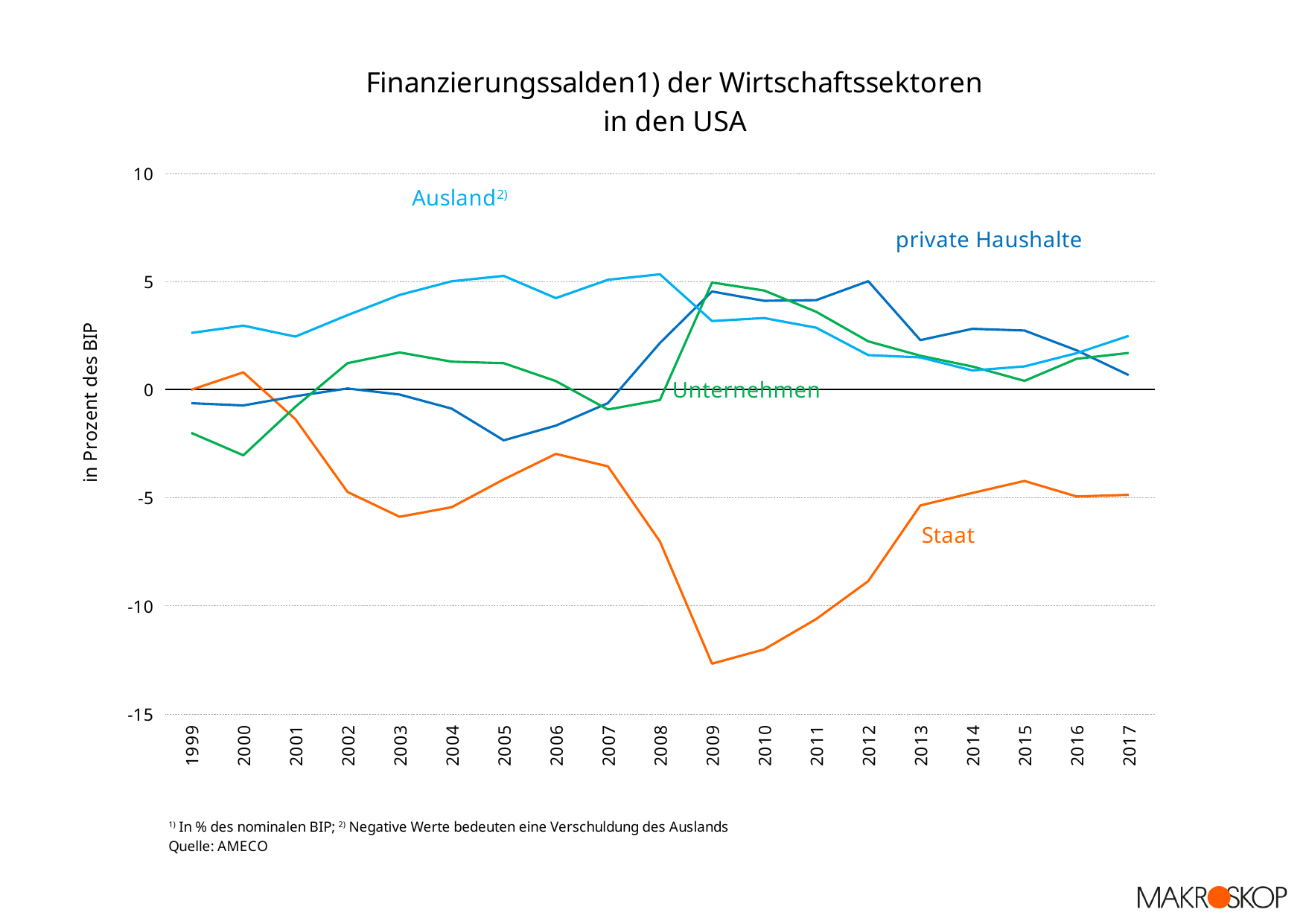
Is the value for Staat in 2003 greater or less than -5? less What kind of chart is shown on the slide? line chart How many series are plotted in the chart? 4 In which year does the Staat series reach its lowest value? 2009 Is the value for Unternehmen in 2000 greater or less than 0? less How many years are shown on the x axis? 19 Which series has the lowest value in 2009? Staat Does the Staat series rise or fall between 2009 and 2015? rise Is the value for private Haushalte in 2005 greater or less than 0? less In 2003, which is larger: the value for Ausland or the value for Unternehmen? Ausland What is the label of the y axis? in Prozent des BIP